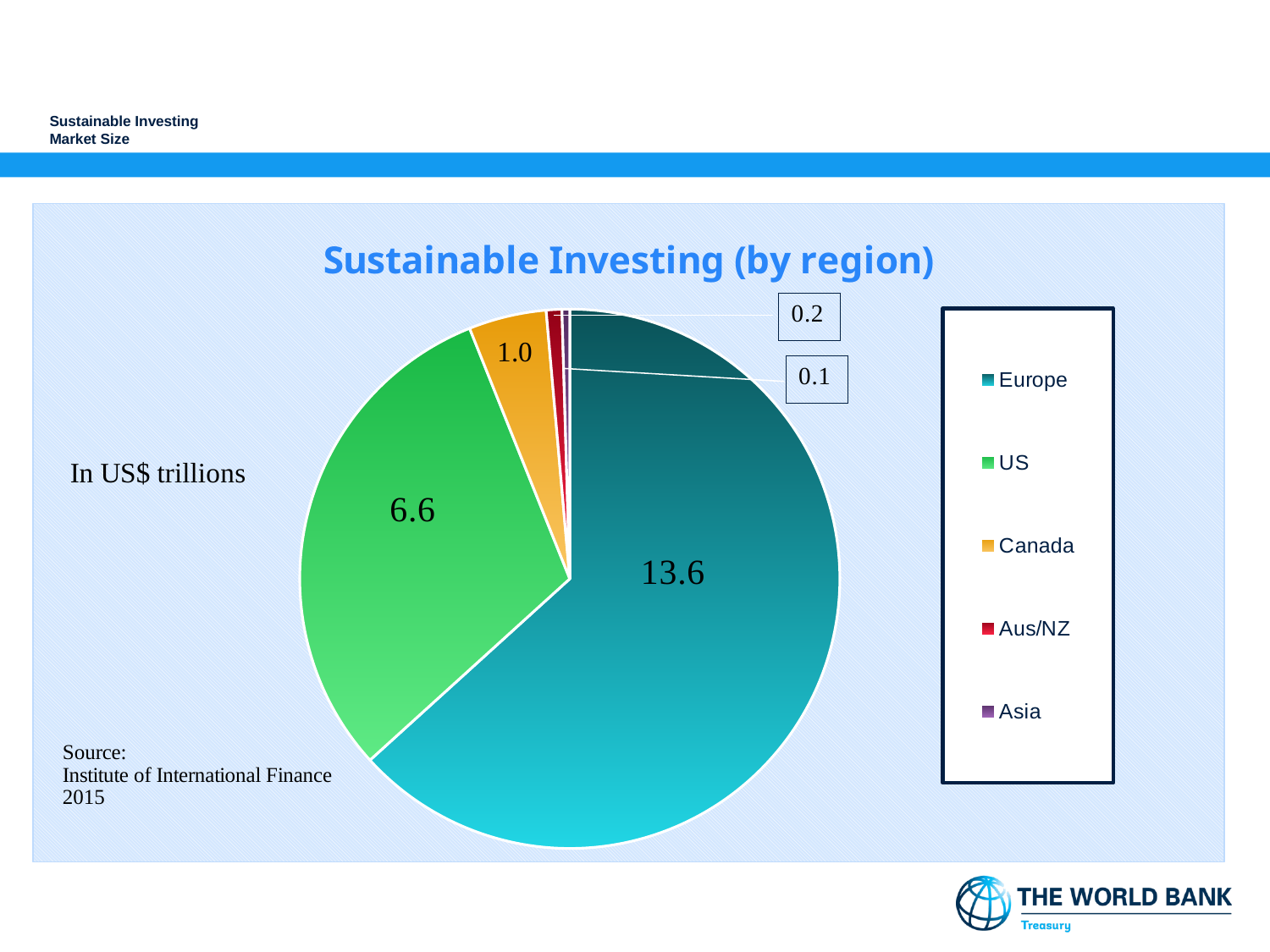
Which region has the smallest slice in the pie chart? Asia How many regions are shown in the pie chart? 5 What is the value for Europe in the Sustainable Investing (by region) pie chart? 13.6 What is the value for the US in the pie chart? 6.6 What is the value for Canada in the pie chart? 1.0 What is the value for Asia in the pie chart? 0.1 Which is larger, the value for Canada or the value for Aus/NZ? Canada What is the difference between the values for Europe and the US? 7.0 What is the value for Aus/NZ in the pie chart? 0.2 Which region has the largest slice in the pie chart? Europe In what units are the values in the chart expressed? US$ trillions What type of chart is shown on the slide? Pie chart